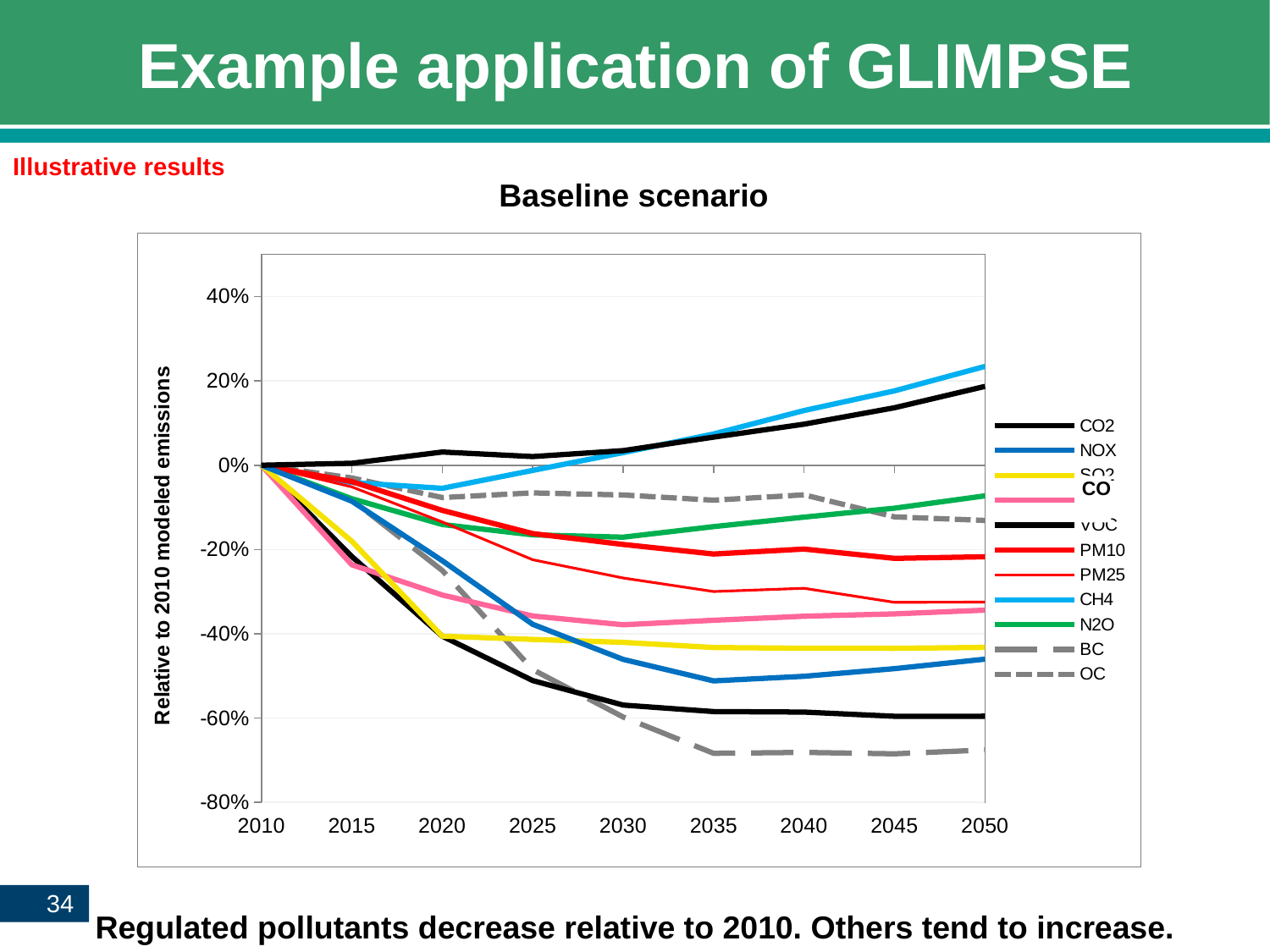
What kind of chart is shown on the slide? line chart Does the BC line rise or fall from 2010 to 2035? falls Is the value for NOX in 2035 greater or less than -40%? less How many year points are labelled on the x axis? 9 How many series does the legend list? 11 What is the title of the chart? Baseline scenario Is the value for N2O in 2050 greater or less than -20%? greater Which series has the lowest value in 2050? BC Which series has the highest value in 2050? CH4 In 2050, which is higher, PM10 or PM25? PM10 Is the value for BC in 2050 greater or less than -60%? less Does the CO2 line rise or fall from 2010 to 2050? rises